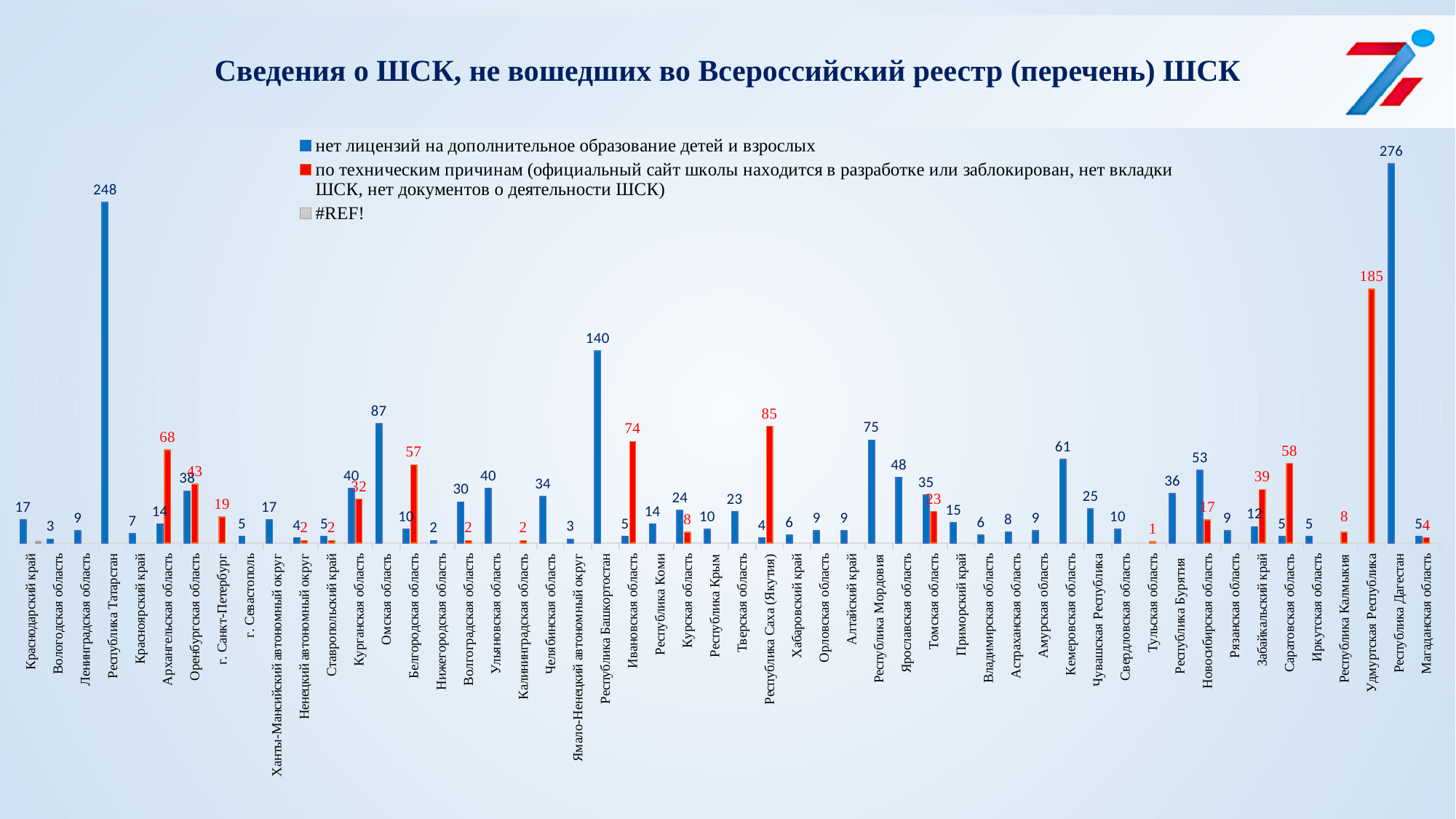
What is the value for Республика Дагестан in the series 'нет лицензий на дополнительное образование детей и взрослых'? 276 What is the total of the two plotted values for Курганская область? 72 What is the value for Республика Башкортостан in the series 'нет лицензий на дополнительное образование детей и взрослых'? 140 Which region has the highest value in the series 'по техническим причинам'? Удмуртская Республика What is the title of the chart? Сведения о ШСК, не вошедших во Всероссийский реестр (перечень) ШСК What type of chart is shown on the slide? bar chart What is the value for Удмуртская Республика in the series 'по техническим причинам'? 185 Which region has the highest value in the series 'нет лицензий на дополнительное образование детей и взрослых'? Республика Дагестан What is the 'по техническим причинам' value for Республика Саха (Якутия)? 85 How many series does the legend list? 3 Which is larger for Архангельская область: the 'нет лицензий' value or the 'по техническим причинам' value? по техническим причинам What is the difference between the 'нет лицензий' values for Республика Татарстан and Республика Башкортостан? 108